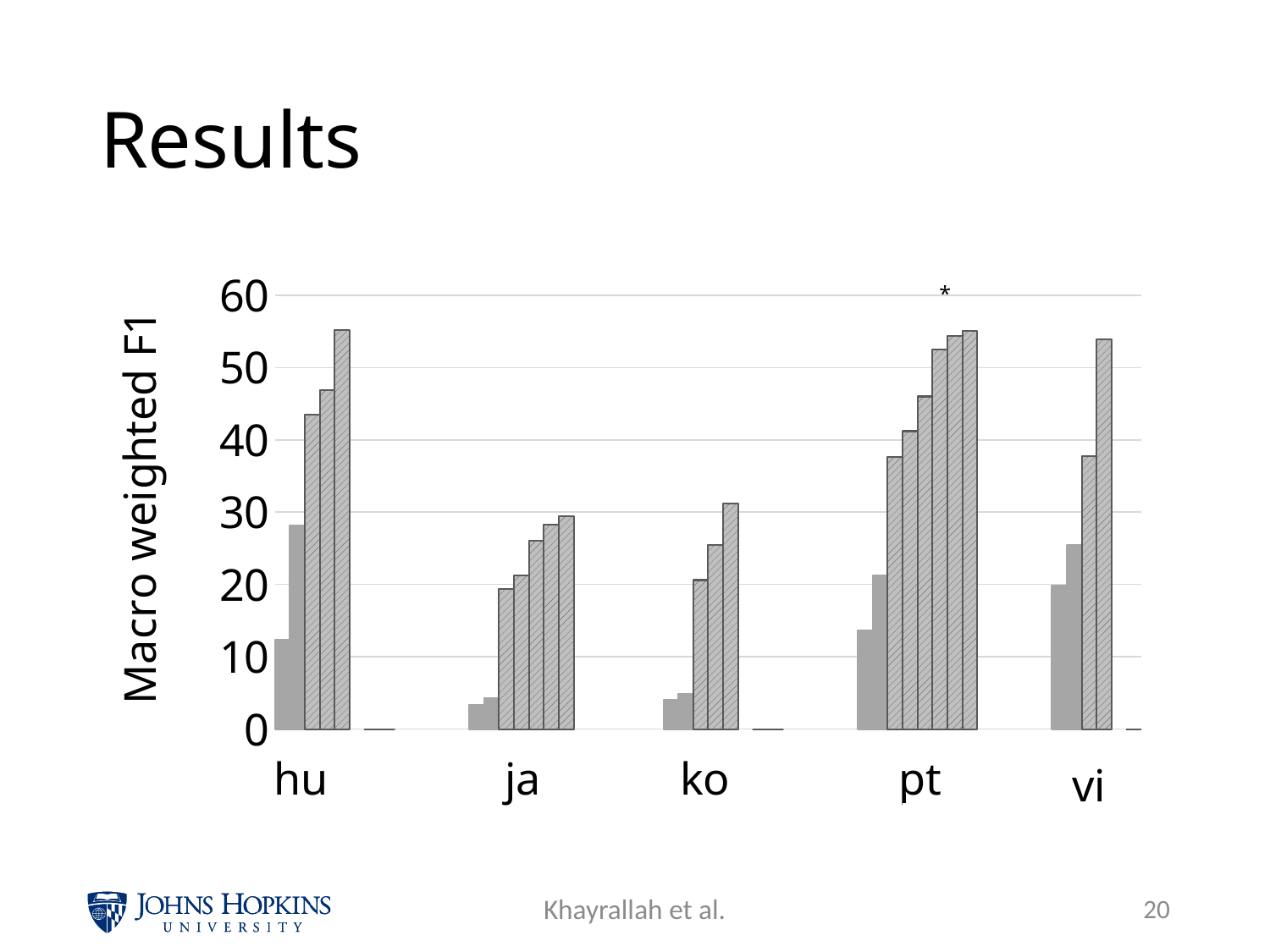
Is the tallest bar for hu greater or less than 50? greater Is the leftmost solid bar for hu greater or less than 20? less Within the pt group, do the bars rise or fall from left to right? rise How many language categories are shown on the x axis? 5 What is the label of the y axis? Macro weighted F1 Which category has the taller tallest bar, ja or pt? pt Is the tallest bar for ko greater or less than 40? less What kind of chart is shown on the slide? bar chart Which category has an asterisk marked above its bars? pt